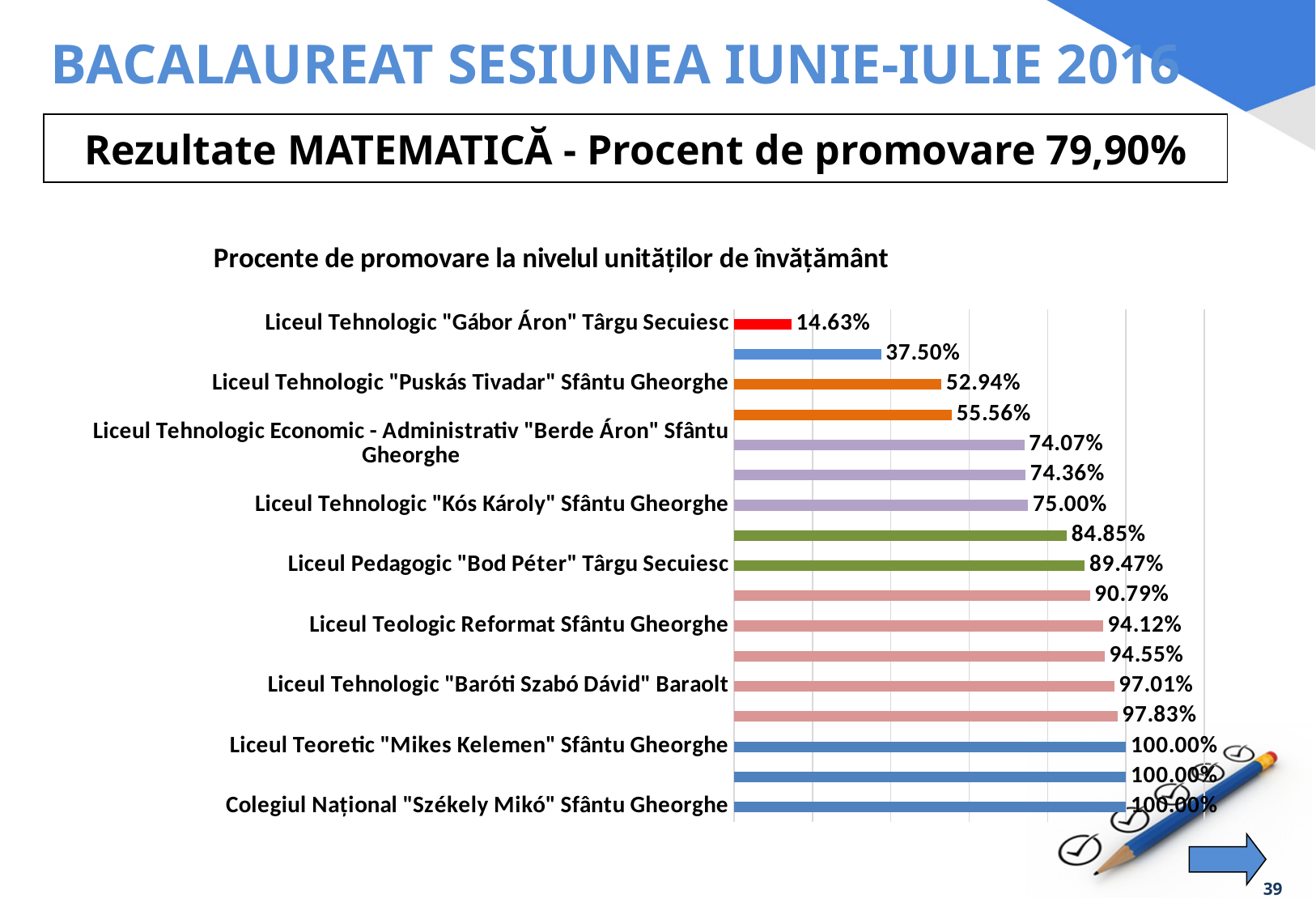
What is the promotion percentage for Liceul Pedagogic "Bod Péter" Târgu Secuiesc? 89.47% What is the promotion percentage for Colegiul Național "Székely Mikó" Sfântu Gheorghe? 100.00% What is the title of the chart? Procente de promovare la nivelul unităților de învățământ What kind of chart is shown on the slide? bar chart How many bars are plotted in the chart? 17 Do the bar values increase or decrease going from the top of the chart to the bottom? increase What is the promotion percentage for Liceul Tehnologic "Baróti Szabó Dávid" Baraolt? 97.01% Which has a higher promotion percentage: Liceul Tehnologic "Kós Károly" Sfântu Gheorghe or Liceul Tehnologic Economic - Administrativ "Berde Áron" Sfântu Gheorghe? Liceul Tehnologic "Kós Károly" Sfântu Gheorghe What is the promotion percentage for Liceul Tehnologic "Gábor Áron" Târgu Secuiesc? 14.63% Which school has the lowest promotion percentage in the chart? Liceul Tehnologic "Gábor Áron" Târgu Secuiesc What is the difference between the promotion percentages of Liceul Pedagogic "Bod Péter" Târgu Secuiesc and Liceul Tehnologic "Kós Károly" Sfântu Gheorghe? 14.47% What is the promotion percentage for Liceul Tehnologic "Puskás Tivadar" Sfântu Gheorghe? 52.94%